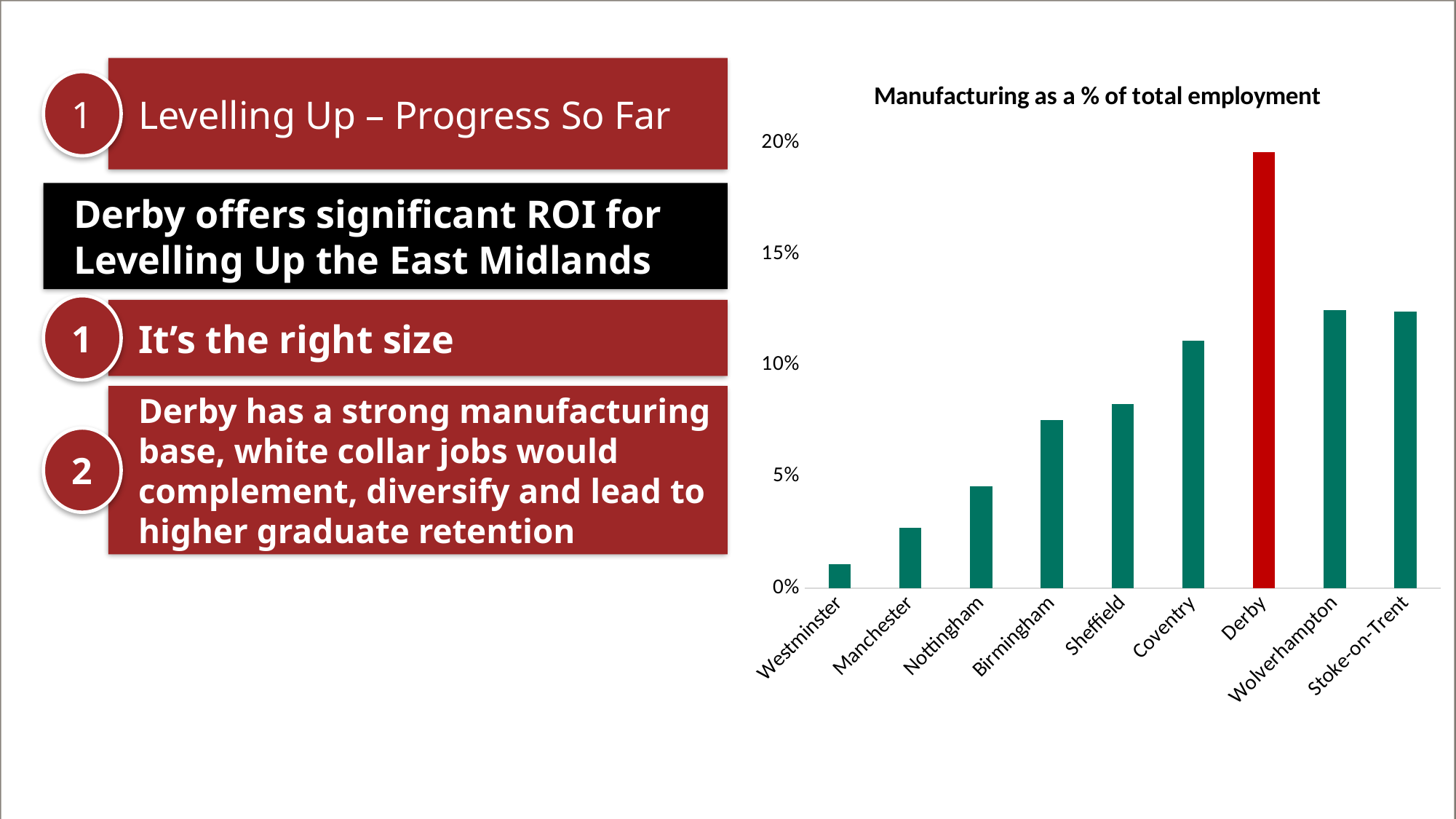
Is the value for Birmingham greater or less than 5%? greater Is the value for Coventry greater or less than 10%? greater What type of chart is shown on the slide? Bar chart Is the value for Westminster greater or less than 5%? less Which city has the lowest manufacturing share of total employment? Westminster What is the title of the chart? Manufacturing as a % of total employment Which city has the highest manufacturing share of total employment? Derby Which bar is coloured differently (red) from the others in the chart? Derby Which has a higher manufacturing share, Manchester or Sheffield? Sheffield How many cities are shown on the x axis of the chart? 9